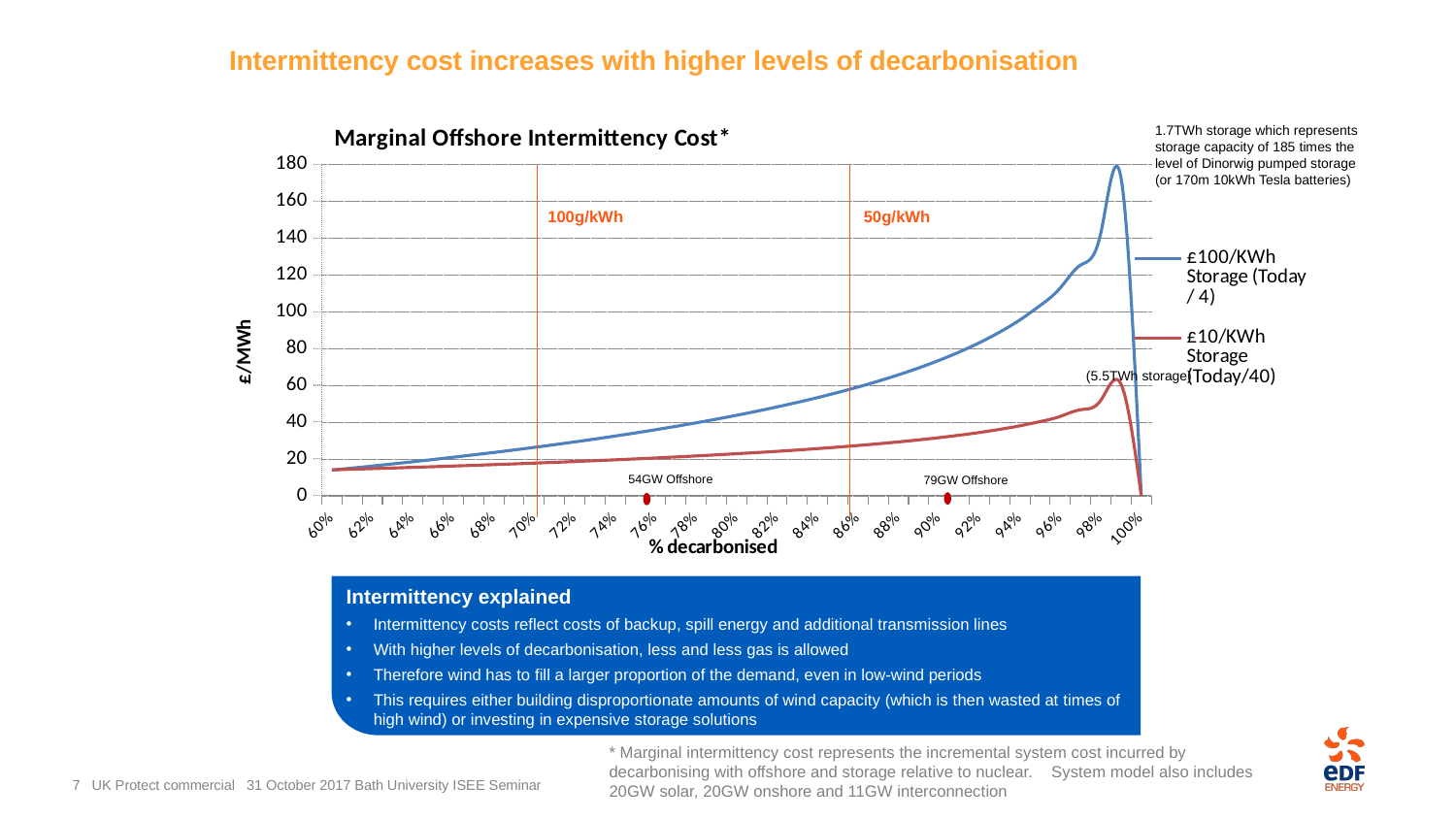
Is the peak value of the £10/KWh Storage (Today/40) series greater or less than 80? less Which series reaches the higher peak value, £100/KWh Storage (Today / 4) or £10/KWh Storage (Today/40)? £100/KWh Storage (Today / 4) What kind of chart is shown on the slide? Line chart Is the value of the £100/KWh Storage (Today / 4) series at 90% decarbonised greater or less than 60? greater Is the value of the £10/KWh Storage (Today/40) series at 80% decarbonised greater or less than 40? less Between 60% and 96% decarbonised, does the £10/KWh Storage (Today/40) series rise or fall? rise Between 60% and 98% decarbonised, does the £100/KWh Storage (Today / 4) series rise or fall? rise What is the title of the chart? Marginal Offshore Intermittency Cost* How many series does the legend of the chart list? 2 At 90% decarbonised, which series has the larger value, £100/KWh Storage (Today / 4) or £10/KWh Storage (Today/40)? £100/KWh Storage (Today / 4) What is the label of the y axis of the chart? £/MWh